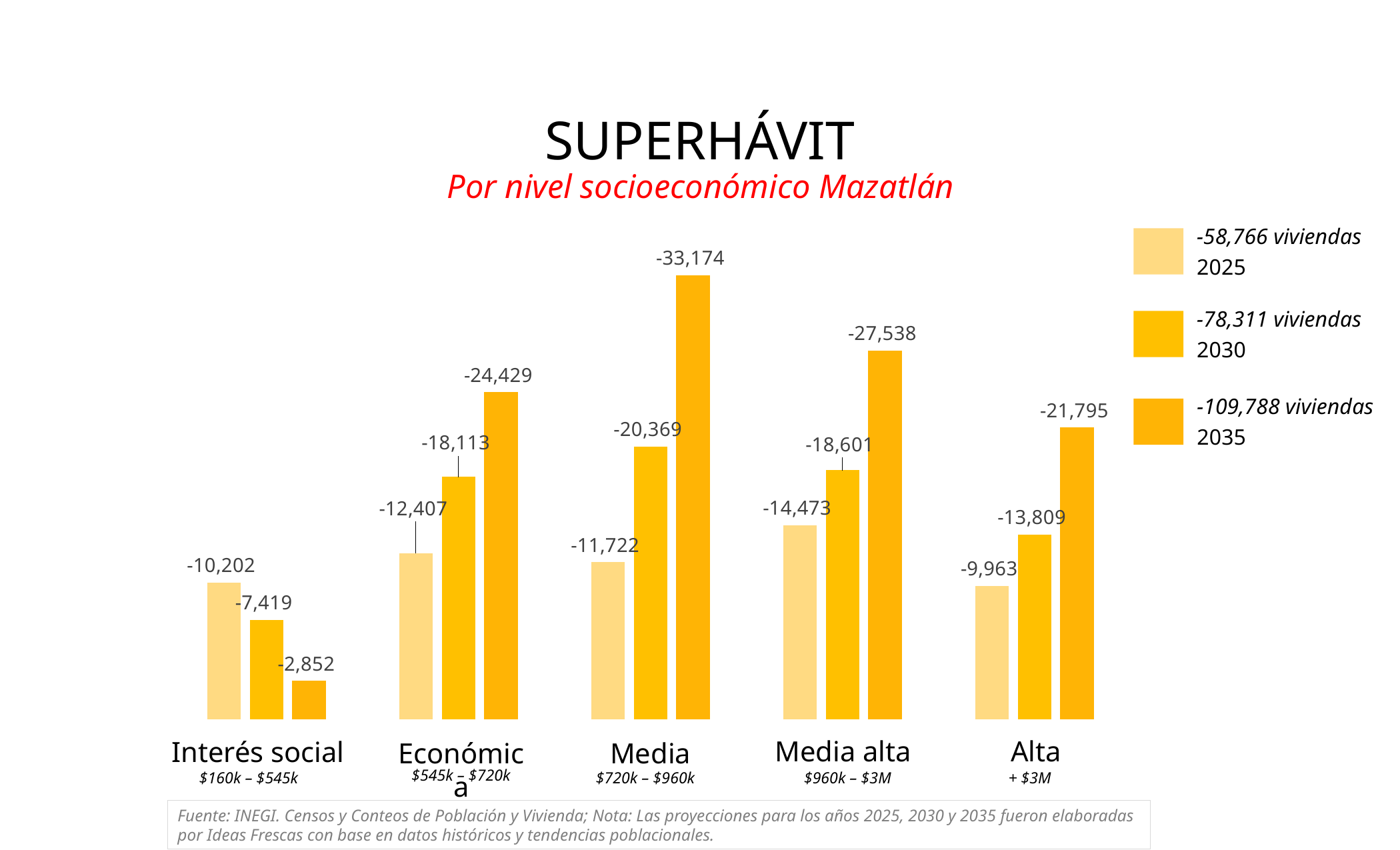
What type of chart is shown on the slide? bar chart How many series does the legend list? 3 Which bar is taller: Económica 2035 or Media alta 2035? Media alta 2035 What is the value for Media in 2035? -33,174 What is the value for Alta in 2025? -9,963 What is the value for Interés social in 2030? -7,419 Which category has the shortest 2035 bar? Interés social According to the legend, what total number of viviendas is shown for 2035? -109,788 viviendas How many socioeconomic categories are shown on the x axis? 5 Which category has the tallest 2035 bar? Media What is the difference between the 2035 and 2030 values for Media? 12,805 What is the value for Media alta in 2035? -27,538